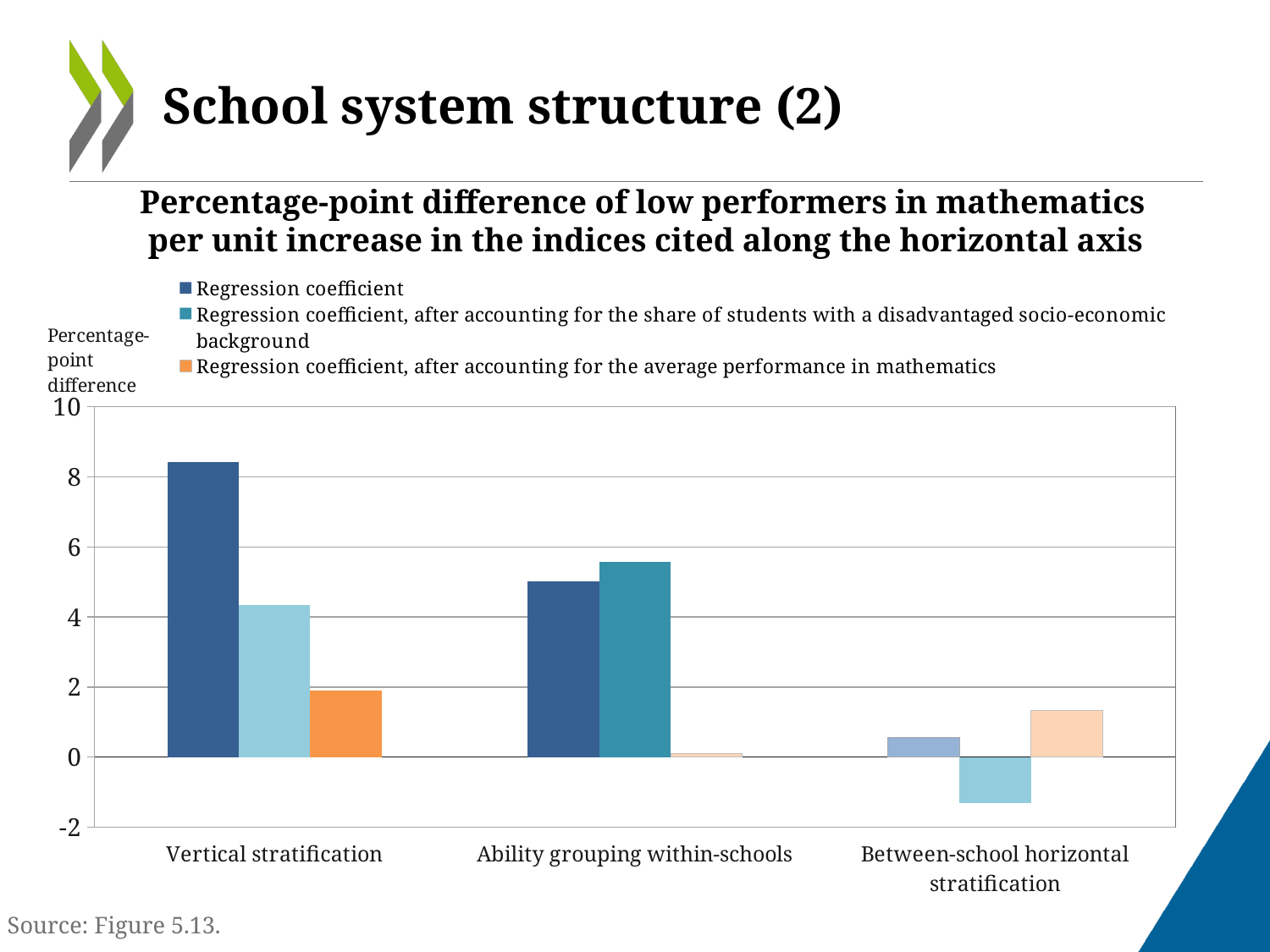
Is the 'Regression coefficient, after accounting for the share of students with a disadvantaged socio-economic background' value for Ability grouping within-schools greater or less than 4? greater How many series does the legend list? 3 Which is larger: the 'Regression coefficient' for Vertical stratification or the 'Regression coefficient' for Ability grouping within-schools? Vertical stratification Which category has the highest 'Regression coefficient' bar? Vertical stratification How many categories are shown along the horizontal axis? 3 For Between-school horizontal stratification, which is larger: the 'Regression coefficient' or the 'Regression coefficient, after accounting for the average performance in mathematics'? Regression coefficient, after accounting for the average performance in mathematics What kind of chart is shown on the slide? Bar chart Is the 'Regression coefficient, after accounting for the share of students with a disadvantaged socio-economic background' value for Between-school horizontal stratification greater or less than 0? less What is the label on the vertical axis of the chart? Percentage-point difference Is the 'Regression coefficient' value for Vertical stratification greater or less than 6? greater Which category has the lowest bar in the chart (the only one below zero)? Between-school horizontal stratification